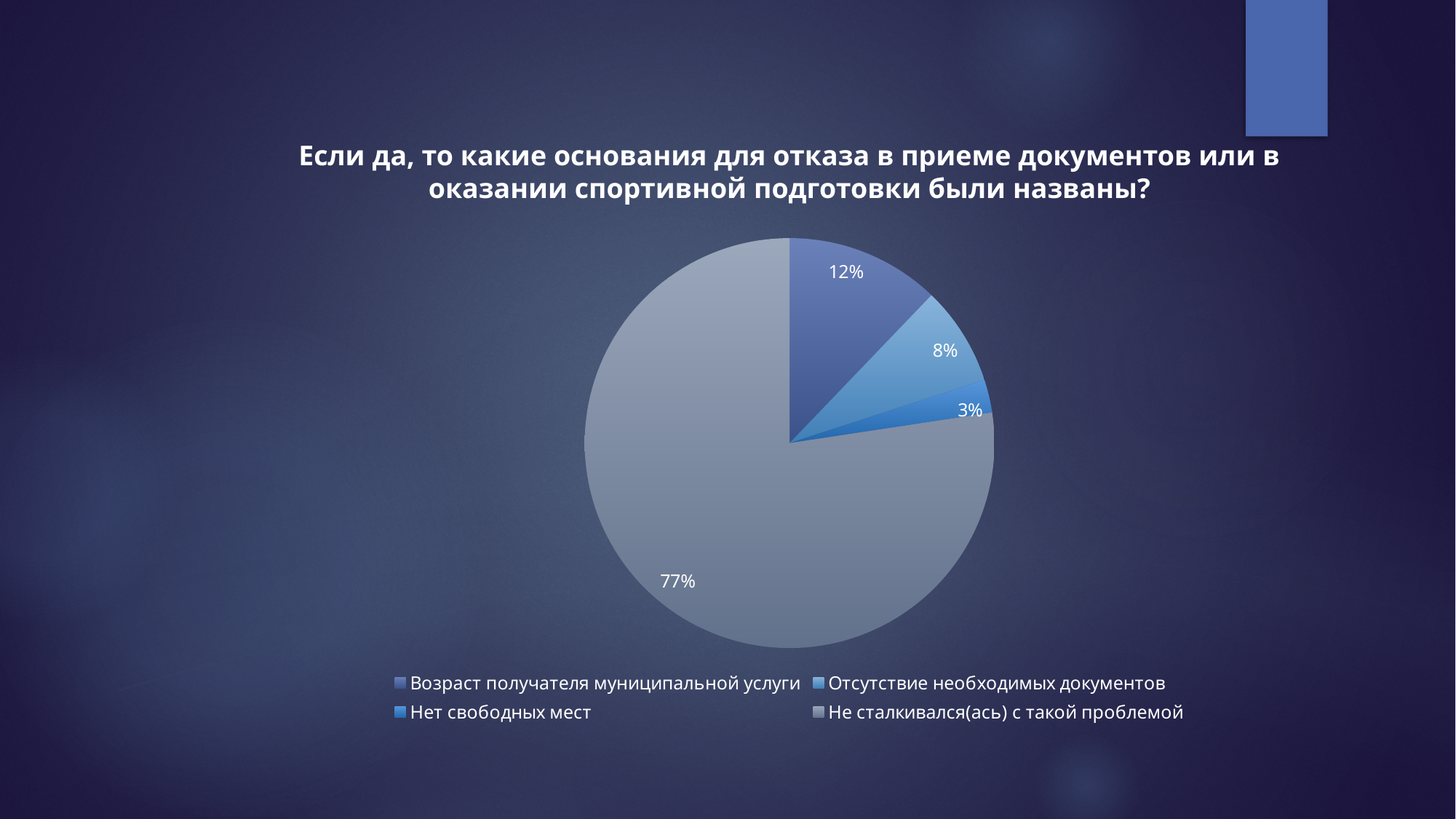
How many entries does the legend list? 4 What percentage is shown for "Возраст получателя муниципальной услуги"? 12% Which category has the largest slice of the pie? Не сталкивался(ась) с такой проблемой What is the title of the chart? Если да, то какие основания для отказа в приеме документов или в оказании спортивной подготовки были названы? What percentage is shown for "Нет свободных мест"? 3% What is the difference in percentage points between "Возраст получателя муниципальной услуги" and "Отсутствие необходимых документов"? 4 What type of chart is shown on the slide? pie chart What percentage is shown for "Отсутствие необходимых документов"? 8% How many slices does the pie chart have? 4 Which is larger: the slice for "Отсутствие необходимых документов" or the slice for "Нет свободных мест"? Отсутствие необходимых документов Which category has the smallest slice of the pie? Нет свободных мест What share of the pie is labelled for "Не сталкивался(ась) с такой проблемой"? 77%